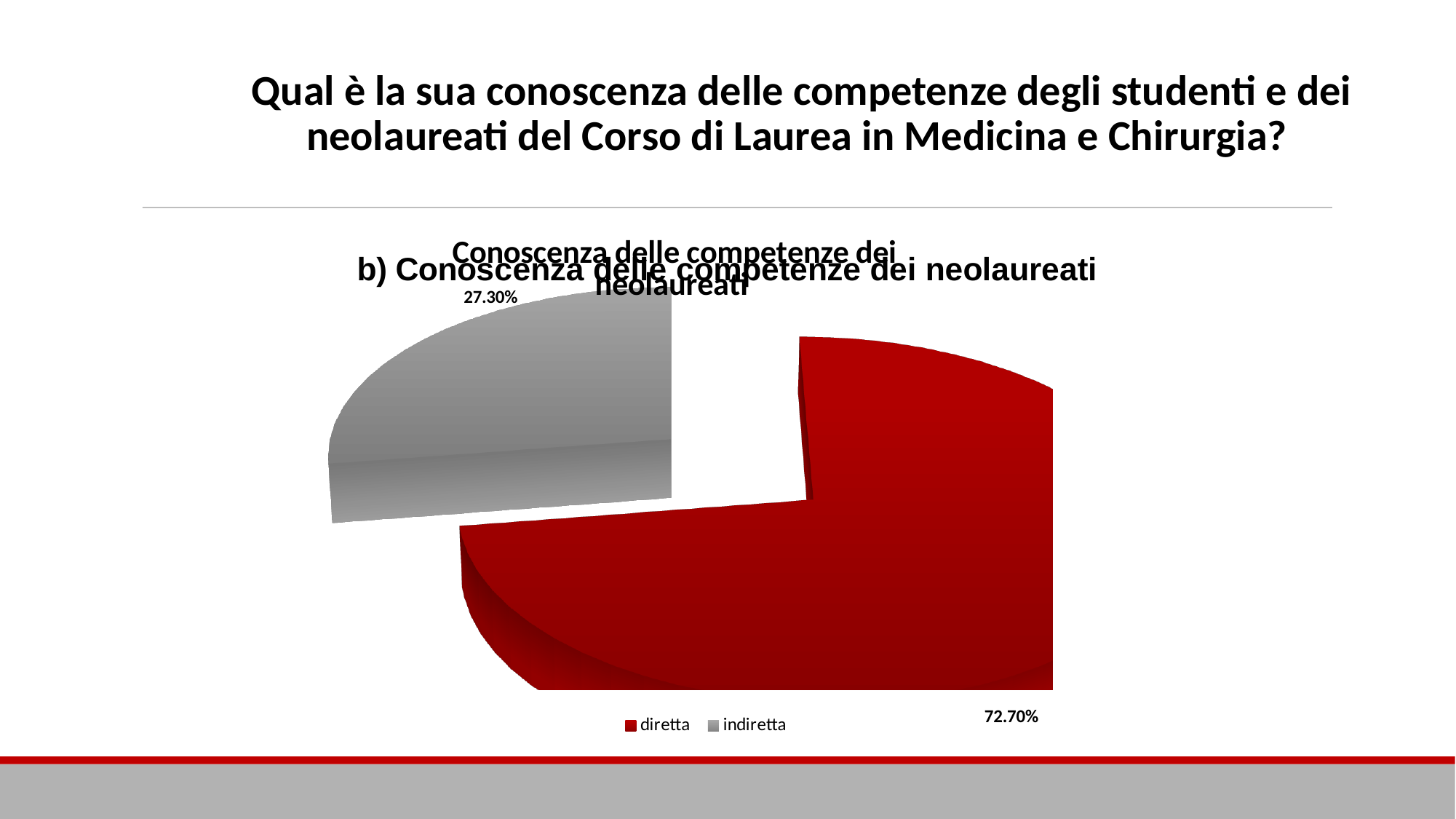
What is the value for "diretta" in the pie chart? 72.70% Which slice of the pie chart is the smallest? indiretta How many entries does the legend list? 2 What kind of chart is shown on the slide? pie chart What is the value for "indiretta" in the pie chart? 27.30% Which is larger, the "diretta" slice or the "indiretta" slice? diretta How many slices does the pie chart have? 2 What share of the pie does the "indiretta" slice represent? 27.30% What colour is the "diretta" slice in the pie chart? red What is the difference between the "diretta" and "indiretta" values? 45.40% What colour is the "indiretta" slice in the pie chart? grey Which slice of the pie chart is the largest? diretta